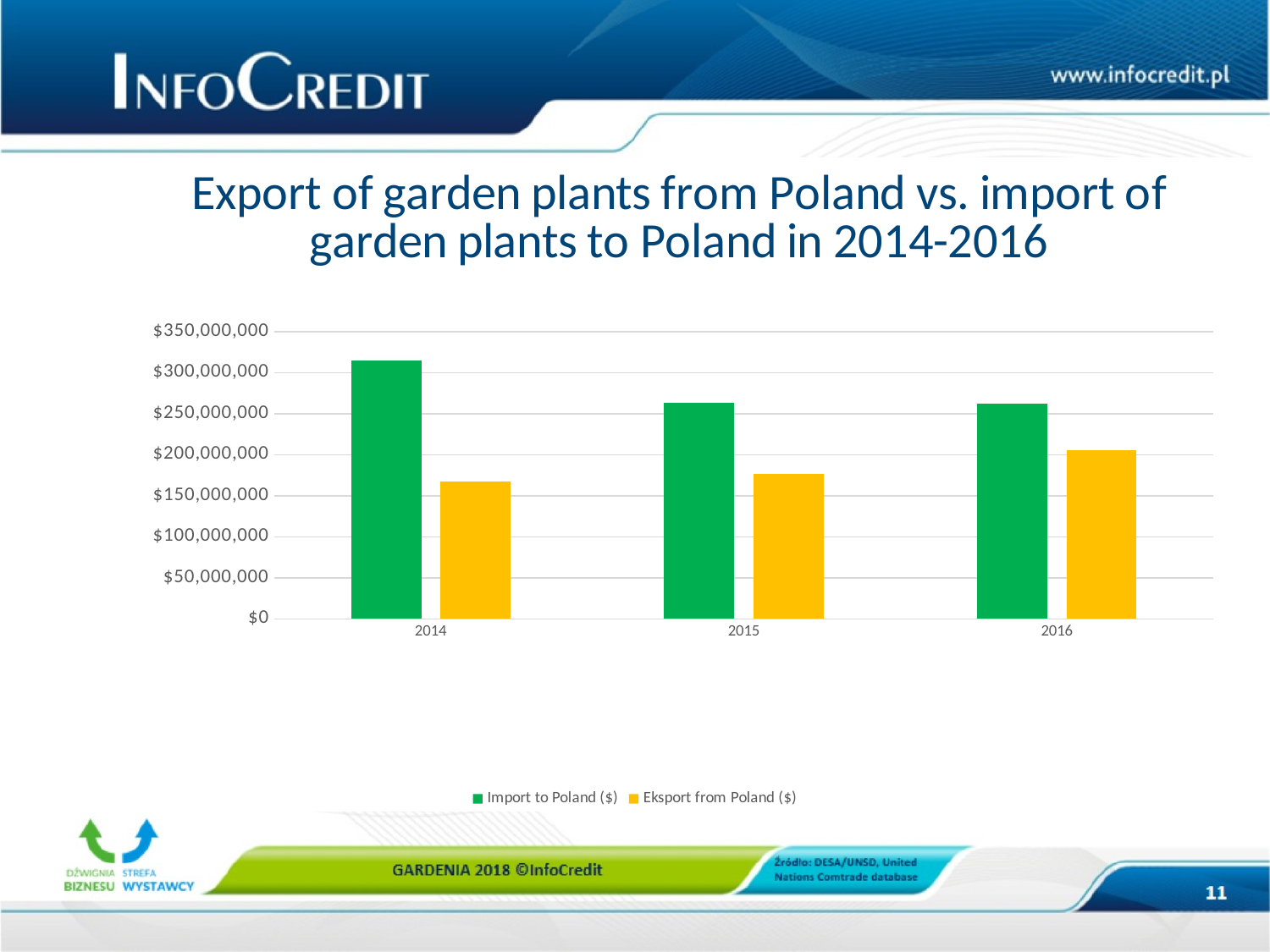
Is the value for Eksport from Poland ($) in 2015 greater or less than $200,000,000? less In which year is the value for Import to Poland ($) highest? 2014 How many series does the chart's legend list? 2 In which year is the value for Eksport from Poland ($) highest? 2016 In 2014, which is larger: Import to Poland ($) or Eksport from Poland ($)? Import to Poland ($) Does the value for Eksport from Poland ($) rise or fall from 2014 to 2016? rise Is the value for Import to Poland ($) in 2014 greater or less than $300,000,000? greater Which colour represents Eksport from Poland ($) in the chart? yellow How many years are shown on the x axis of the chart? 3 What kind of chart is shown on the slide? bar chart In which year is the value for Eksport from Poland ($) lowest? 2014